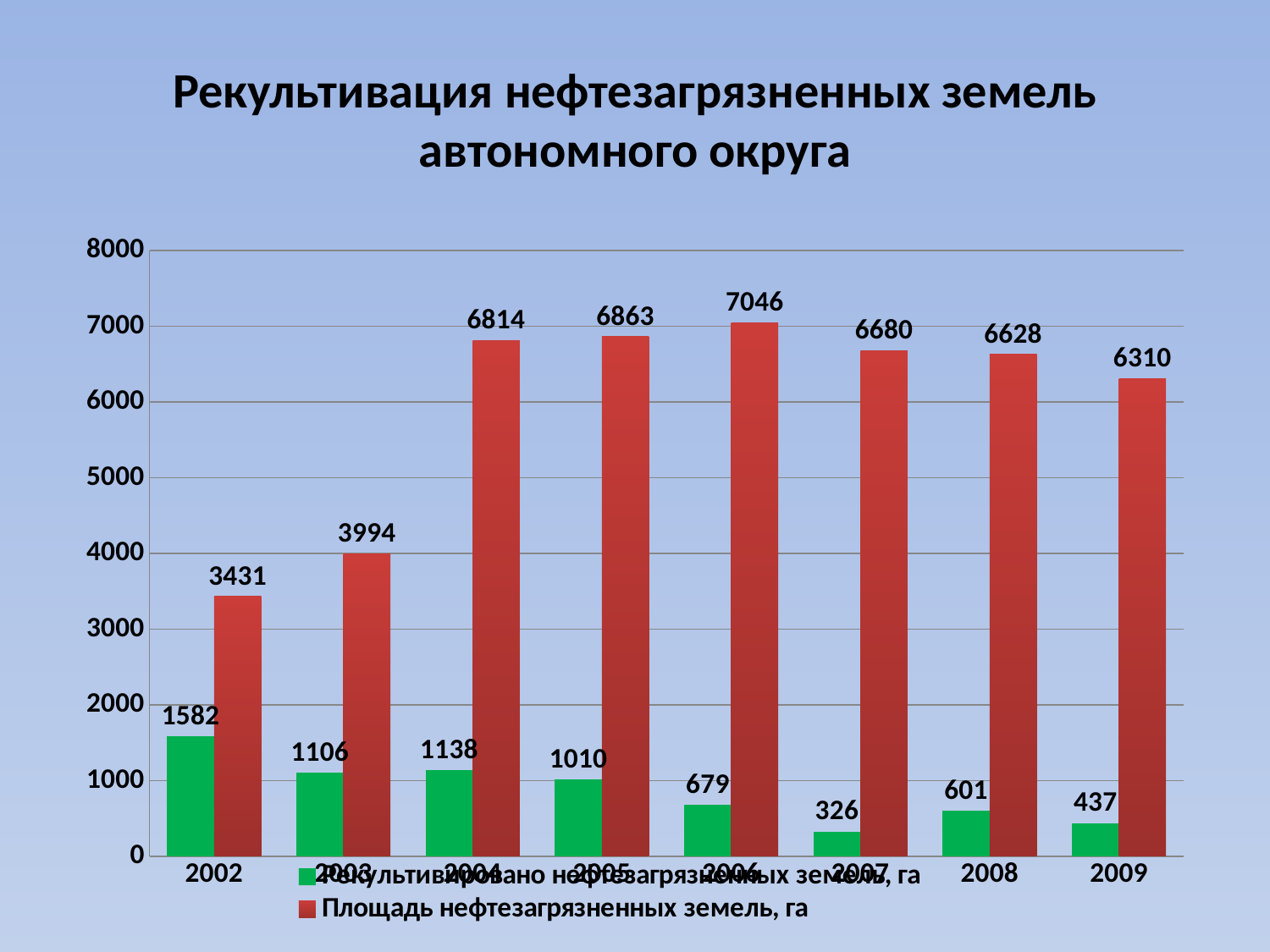
Does the red series (Площадь нефтезагрязненных земель, га) rise or fall from 2006 to 2009? fall What kind of chart is shown on the slide? bar chart Is the red series value for 2009 greater or less than 6000? greater What is the value of the green series (Рекультивировано нефтезагрязненных земель, га) for 2002? 1582 In which year is the red series (Площадь нефтезагрязненных земель, га) highest? 2006 Which is larger: the green series value for 2008 or for 2009? 2008 How many series does the legend list? 2 What is the difference between the red series values for 2003 and 2002? 563 What is the value of the red series (Площадь нефтезагрязненных земель, га) for 2006? 7046 In which year is the green series (Рекультивировано нефтезагрязненных земель, га) lowest? 2007 How many years are shown on the x axis? 8 What is the value of the green series (Рекультивировано нефтезагрязненных земель, га) for 2007? 326